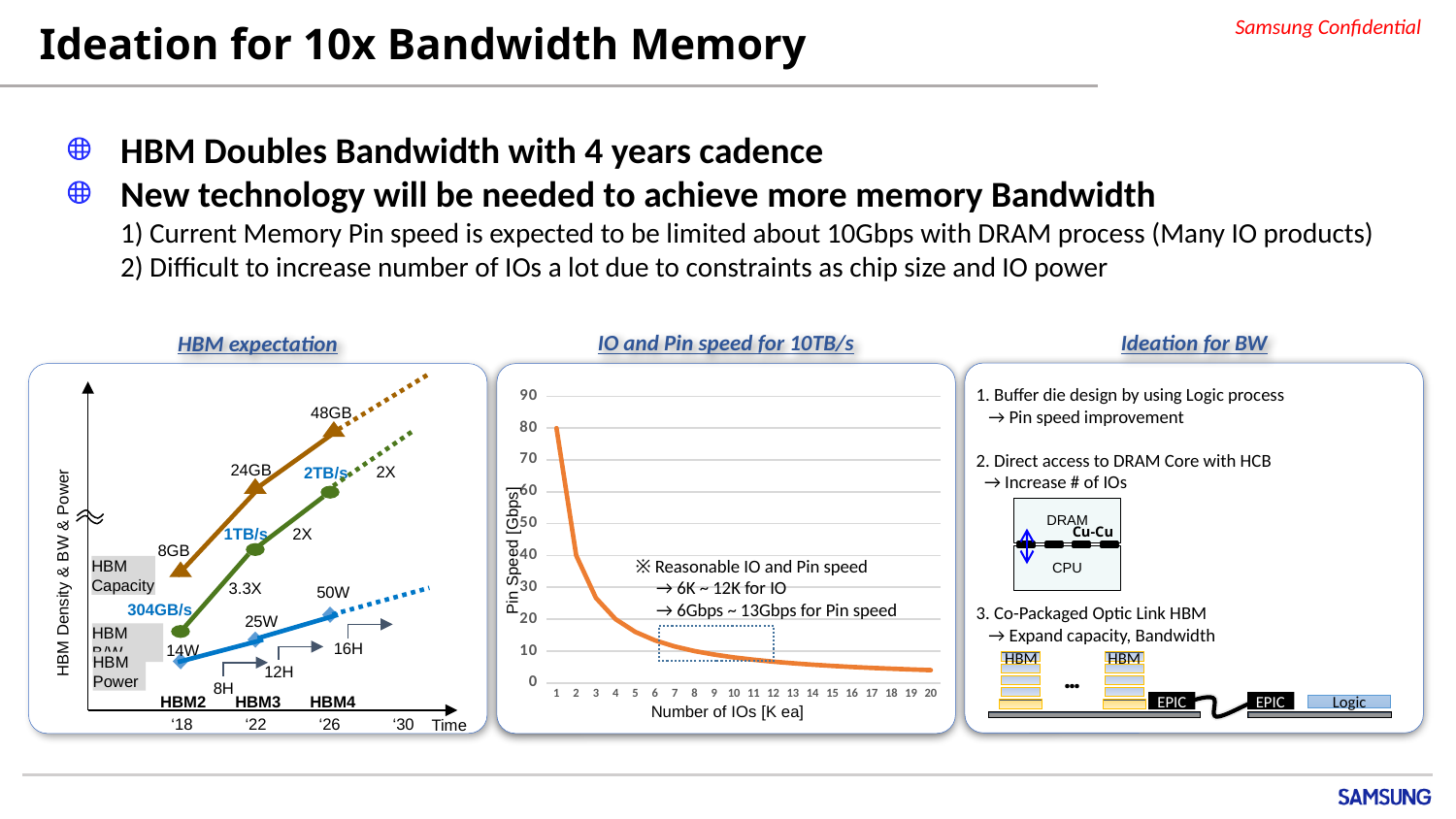
In the 'HBM expectation' chart, what capacity is labeled for HBM4? 48GB In the 'HBM expectation' chart, what power is labeled for HBM2? 14W In the 'IO and Pin speed for 10TB/s' chart, what is the pin speed at 1K IOs? 80 In the 'HBM expectation' chart, which HBM generation has the highest labeled capacity? HBM4 In the 'HBM expectation' chart, how many HBM generations are labeled on the x axis? 3 In the 'IO and Pin speed for 10TB/s' chart, what kind of chart is shown? line chart In the 'IO and Pin speed for 10TB/s' chart, is the pin speed at 20K IOs greater or less than 10? less In the 'IO and Pin speed for 10TB/s' chart, does pin speed rise or fall as the number of IOs increases? fall In the 'HBM expectation' chart, what bandwidth is labeled for HBM3? 1TB/s In the 'IO and Pin speed for 10TB/s' chart, what range of IO count is noted as reasonable? 6K ~ 12K In the 'IO and Pin speed for 10TB/s' chart, is the pin speed at 2K IOs greater or less than 50? less In the 'IO and Pin speed for 10TB/s' chart, what is the label of the x axis? Number of IOs [K ea]